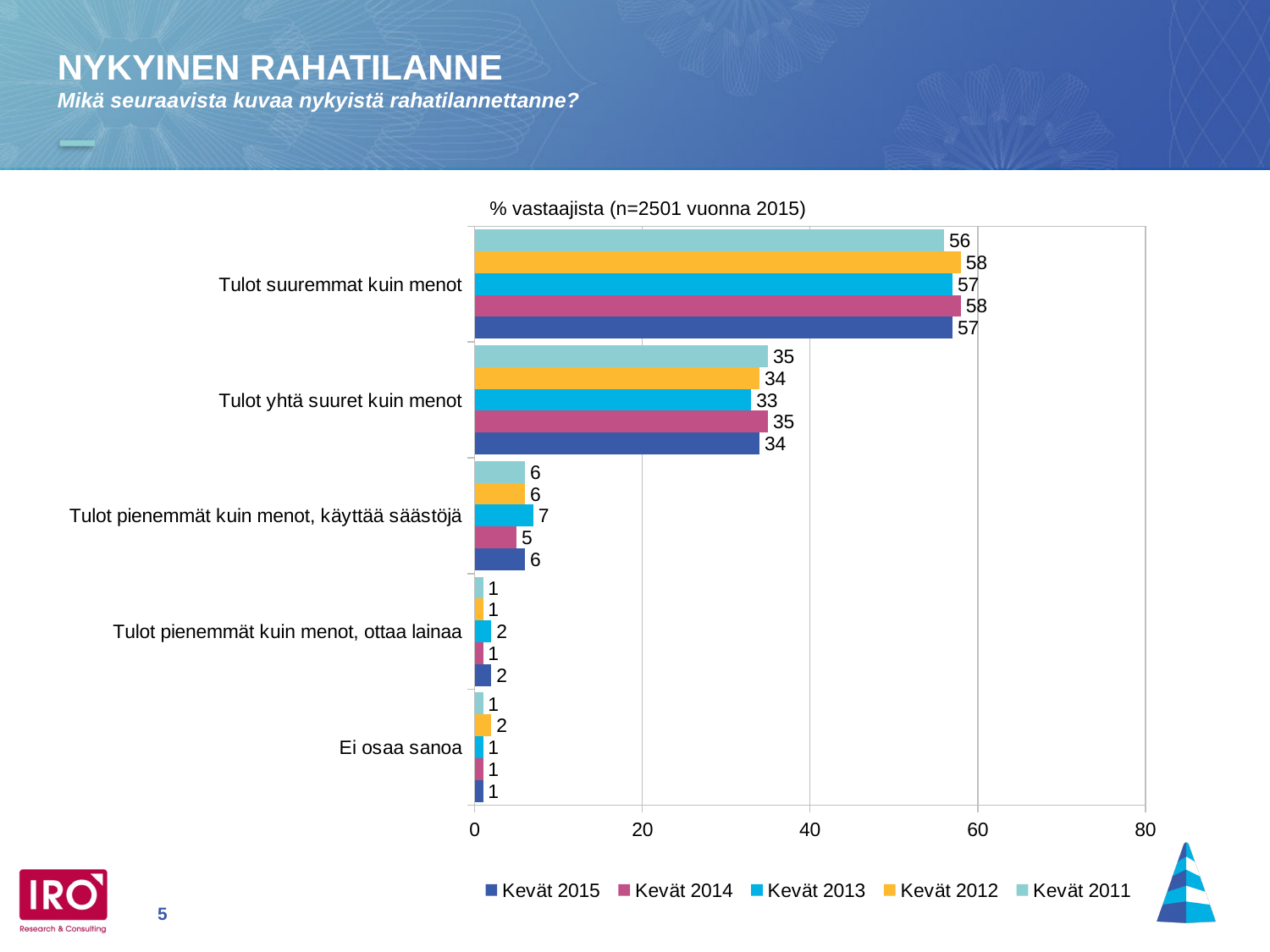
Is the Kevät 2015 value for 'Tulot yhtä suuret kuin menot' greater or less than 40? less What is the title shown above the chart? % vastaajista (n=2501 vuonna 2015) What is the difference between the Kevät 2012 and Kevät 2011 values for 'Tulot suuremmat kuin menot'? 2 Which is larger for 'Tulot pienemmät kuin menot, käyttää säästöjä': the Kevät 2013 value or the Kevät 2014 value? Kevät 2013 Which category has the highest value in the Kevät 2015 series? Tulot suuremmat kuin menot What is the value for 'Tulot suuremmat kuin menot' in the Kevät 2015 series? 57 What is the value for 'Tulot pienemmät kuin menot, käyttää säästöjä' in the Kevät 2014 series? 5 How many categories are shown on the chart? 5 What is the value for 'Ei osaa sanoa' in the Kevät 2012 series? 2 What kind of chart is shown on the slide? bar chart What is the value for 'Tulot yhtä suuret kuin menot' in the Kevät 2013 series? 33 How many series does the legend list? 5